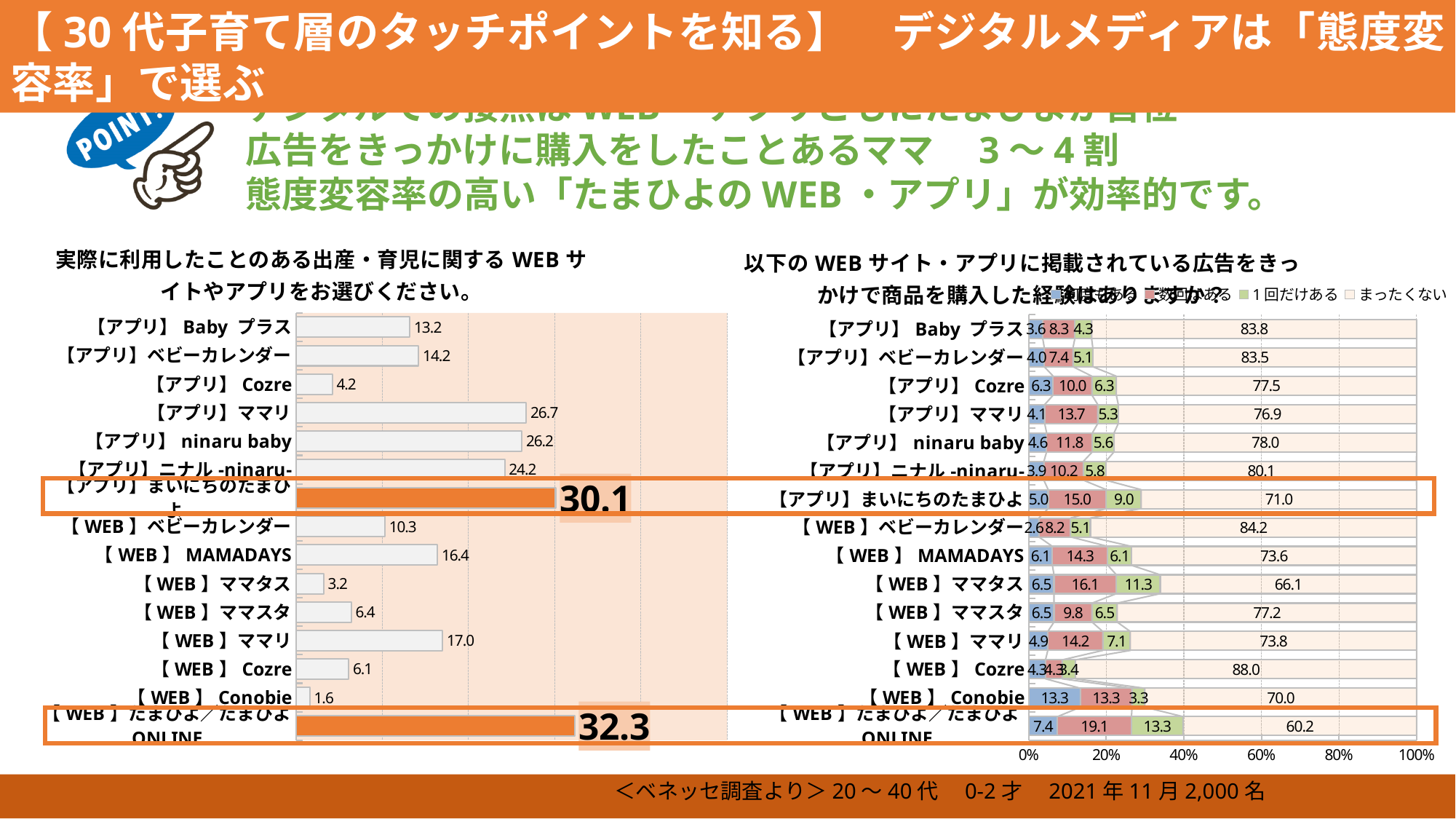
In the right chart (以下の WEB サイト・アプリに掲載されている広告をきっかけで商品を購入した経験はありますか), what is the まったくない value for 【WEB】たまひよ／たまひよ ONLINE? 60.2 In the right chart, what is the まったくない value for 【アプリ】まいにちのたまひよ? 71.0 What kind of chart is the left chart? bar chart How many categories are plotted in the left chart? 15 In the right chart, which category has the highest まったくない value? 【WEB】Cozre In the left chart, which category has the lowest value? 【WEB】Conobie In the left chart, which is larger: 【WEB】MAMADAYS or 【WEB】ママリ? 【WEB】ママリ In the left chart, what is the value for 【WEB】たまひよ／たまひよ ONLINE? 32.3 In the left chart, which category has the highest value? 【WEB】たまひよ／たまひよ ONLINE In the left chart (実際に利用したことのある出産・育児に関する WEB サイトやアプリ), what is the value for 【アプリ】まいにちのたまひよ? 30.1 In the left chart, what is the value for 【アプリ】ママリ? 26.7 In the left chart, what is the difference between 【WEB】たまひよ／たまひよ ONLINE and 【アプリ】まいにちのたまひよ? 2.2